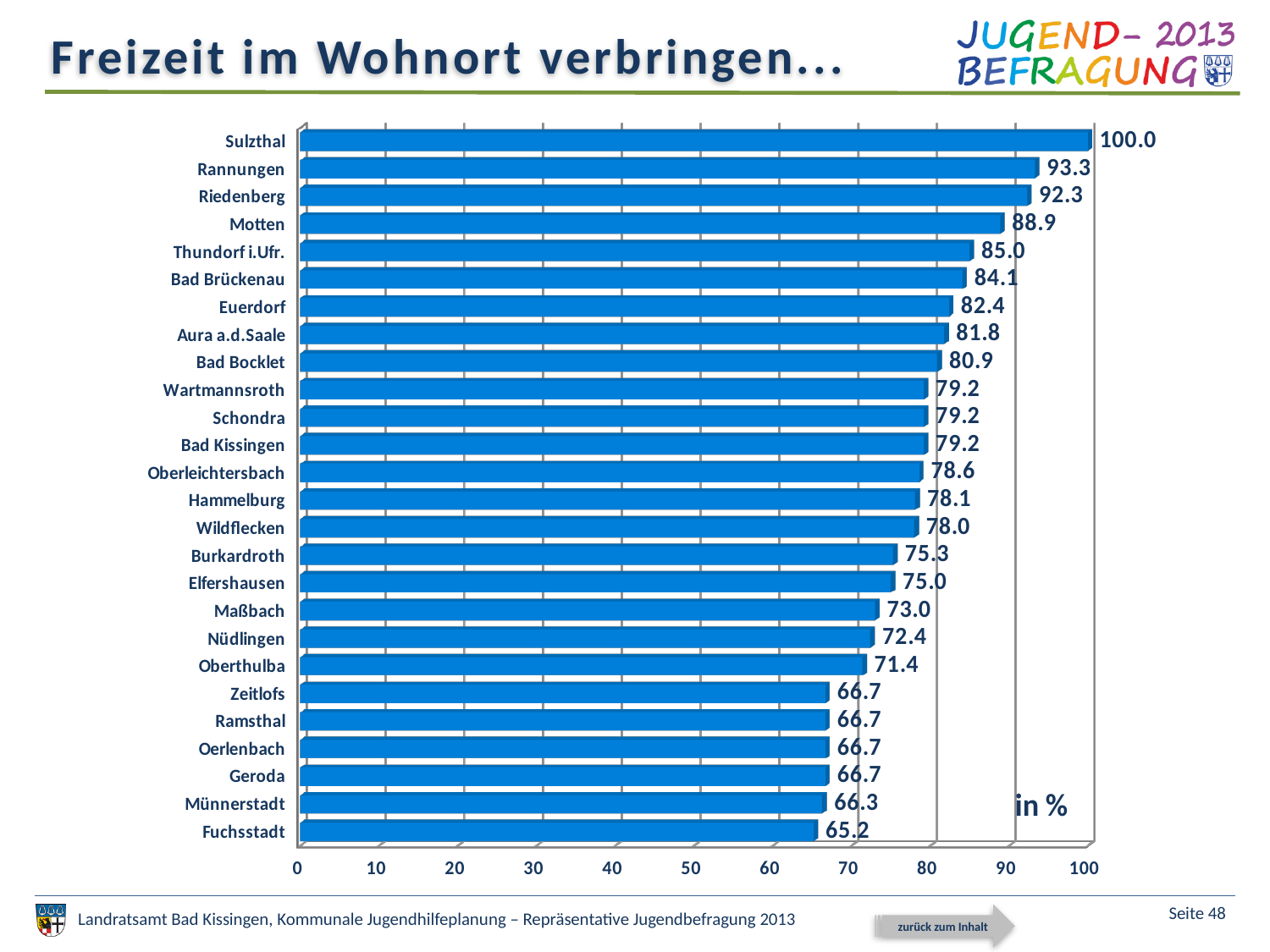
What kind of chart is shown on the slide? bar chart What is the value for Hammelburg? 78.1 Which category has the highest value? Sulzthal Is the value for Oberthulba greater or less than 80? less What is the difference between the values for Rannungen and Riedenberg? 1.0 What is the value for Münnerstadt? 66.3 Which has a larger value, Motten or Euerdorf? Motten Which category has the lowest value? Fuchsstadt What is the value for Sulzthal? 100.0 What is the difference between the values for Sulzthal and Fuchsstadt? 34.8 What is the value for Bad Kissingen? 79.2 How many categories are shown in the chart? 26